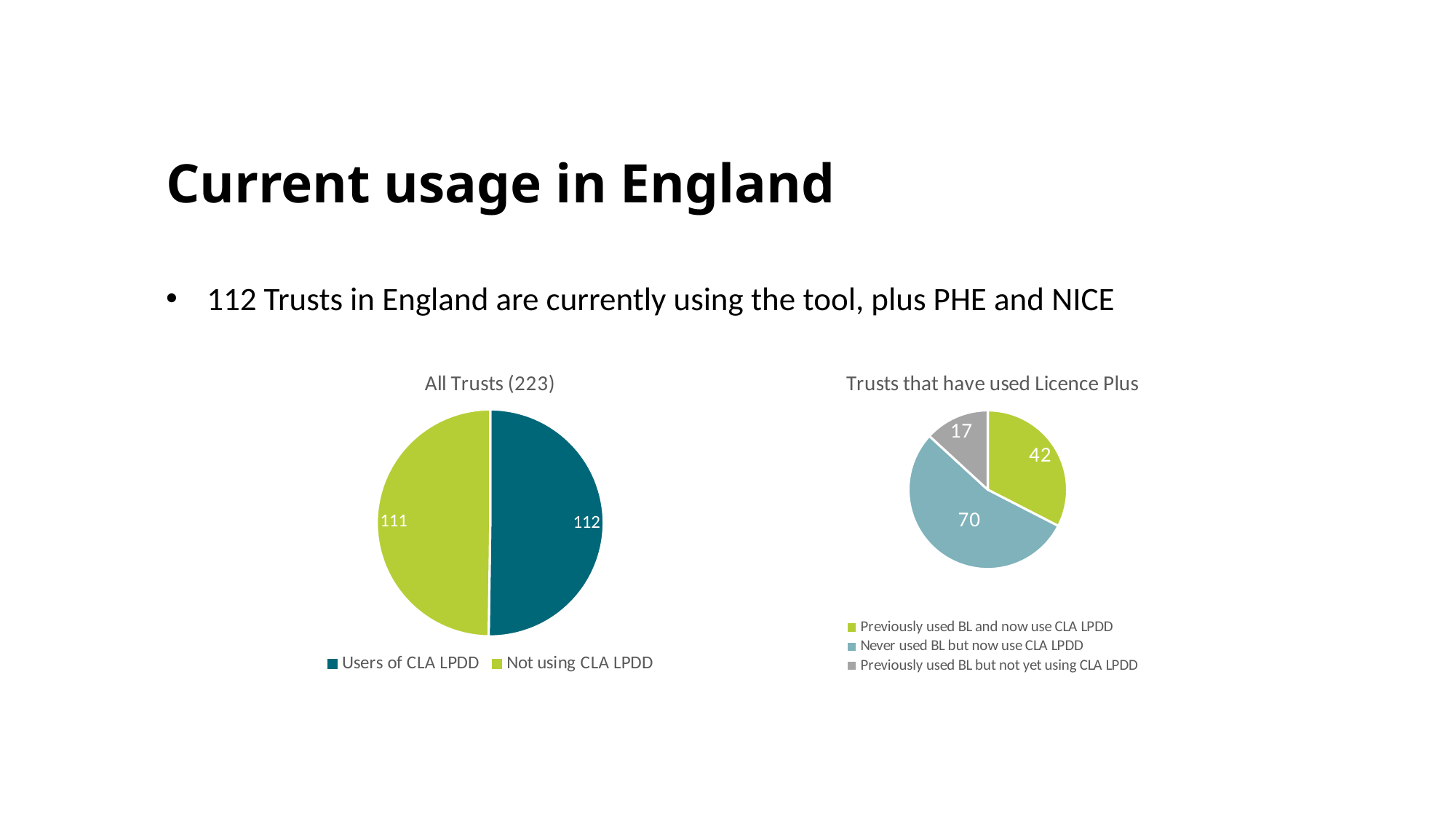
In the 'Trusts that have used Licence Plus' chart, what is the value for 'Previously used BL and now use CLA LPDD'? 42 In the 'Trusts that have used Licence Plus' chart, what is the value for 'Previously used BL but not yet using CLA LPDD'? 17 What type of chart is the 'All Trusts (223)' chart? Pie chart In the 'Trusts that have used Licence Plus' chart, what is the difference between the 'Never used BL but now use CLA LPDD' slice and the 'Previously used BL and now use CLA LPDD' slice? 28 In the 'All Trusts (223)' chart, what is the difference between Users of CLA LPDD and Not using CLA LPDD? 1 In the 'Trusts that have used Licence Plus' chart, which category has the largest slice? Never used BL but now use CLA LPDD In the 'All Trusts (223)' chart, which is larger: Users of CLA LPDD or Not using CLA LPDD? Users of CLA LPDD In the 'All Trusts (223)' chart, what is the value for Users of CLA LPDD? 112 In the 'All Trusts (223)' chart, what is the value for Not using CLA LPDD? 111 In the 'Trusts that have used Licence Plus' chart, which category has the smallest slice? Previously used BL but not yet using CLA LPDD How many slices does the 'Trusts that have used Licence Plus' chart have? 3 In the 'Trusts that have used Licence Plus' chart, what is the value for 'Never used BL but now use CLA LPDD'? 70